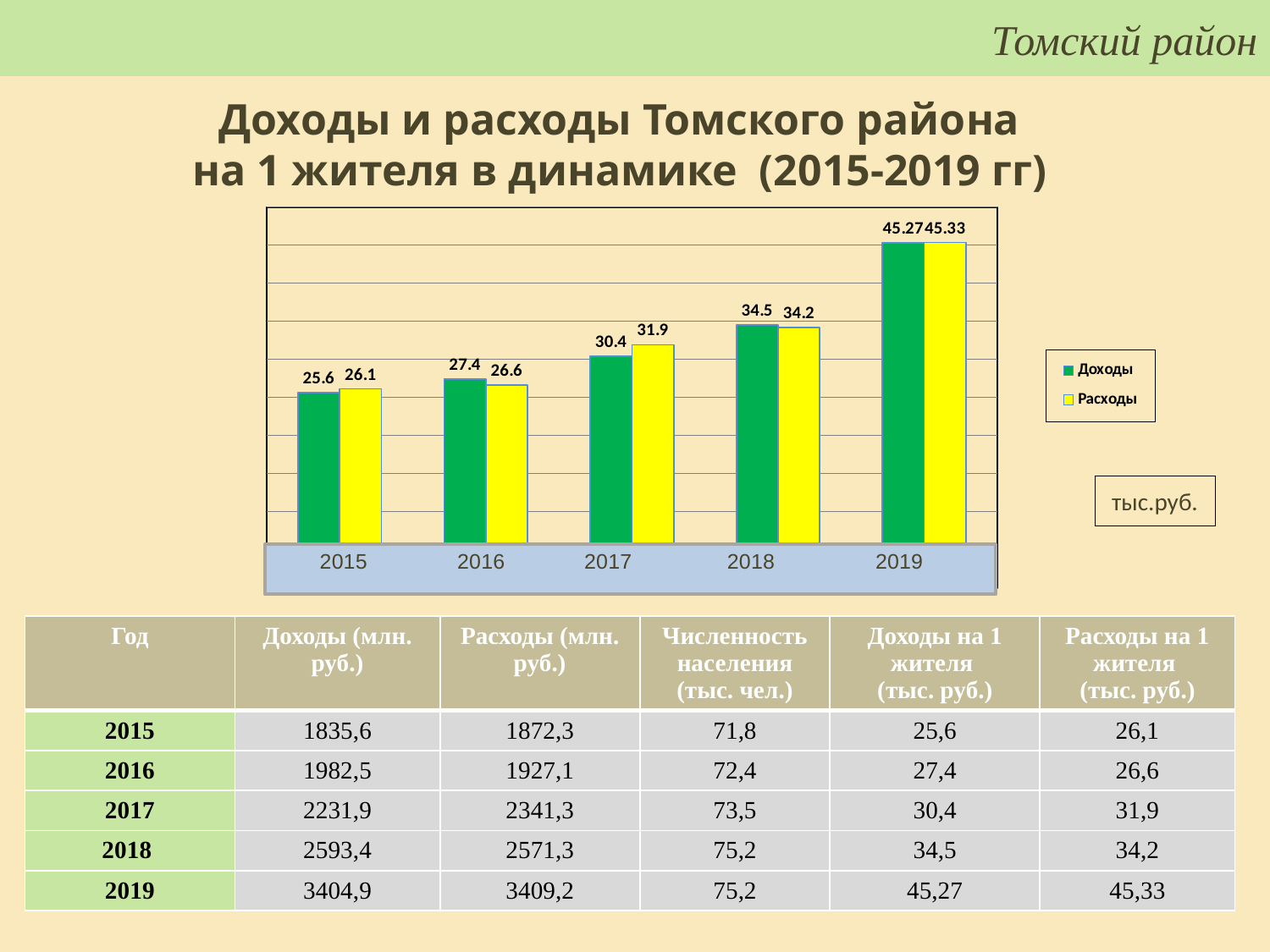
Do the Доходы values rise or fall from 2015 to 2019 in the chart? rise How many years are shown on the x axis of the chart? 5 Which is larger for 2016 in the chart, Доходы or Расходы? Доходы What is the value of Расходы for 2015 in the chart? 26.1 What is the value of Доходы for 2017 in the chart? 30.4 In which year is Доходы highest in the chart? 2019 How many series does the chart legend list? 2 What is the difference between Расходы and Доходы for 2017 in the chart? 1.5 What kind of chart is shown on the slide? bar chart What is the difference between Доходы and Расходы for 2016 in the chart? 0.8 What is the value of Расходы for 2019 in the chart? 45.33 In which year is Расходы lowest in the chart? 2015